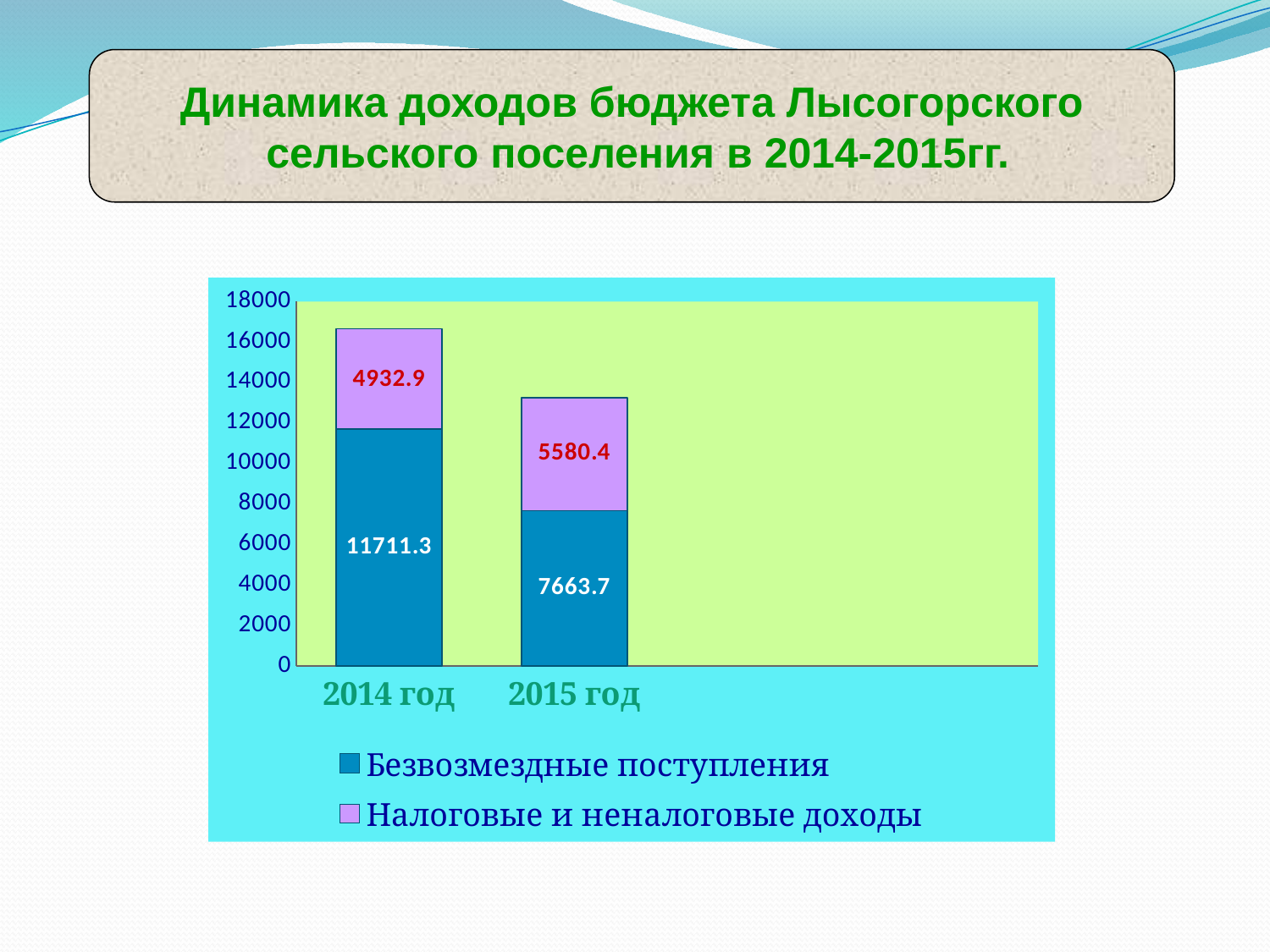
By how much did Безвозмездные поступления decrease from 2014 год to 2015 год? 4047.6 What is the value of Налоговые и неналоговые доходы for 2015 год? 5580.4 What is the total of the stacked bar for 2014 год? 16644.2 What is the value of Безвозмездные поступления for 2015 год? 7663.7 What is the value of Налоговые и неналоговые доходы for 2014 год? 4932.9 Which series is shown in purple in the legend? Налоговые и неналоговые доходы Which year has the larger value for Налоговые и неналоговые доходы, 2014 год or 2015 год? 2015 год What is the value of Безвозмездные поступления for 2014 год? 11711.3 What is the difference in Налоговые и неналоговые доходы between 2015 год and 2014 год? 647.5 What kind of chart is shown on the slide? Stacked bar chart How many series does the legend list? 2 What is the total of the stacked bar for 2015 год? 13244.1